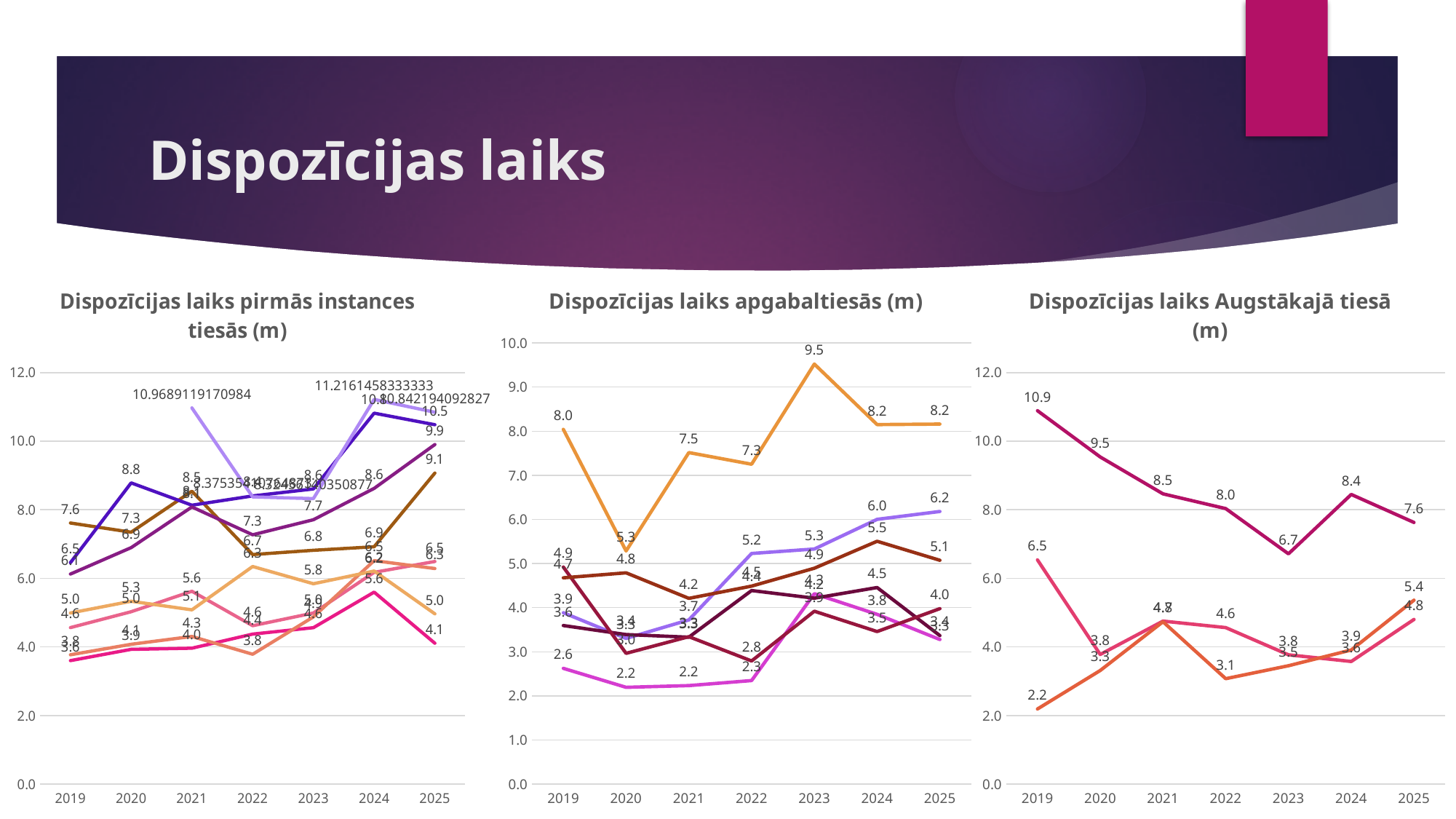
In the chart "Dispozīcijas laiks Augstākajā tiesā (m)", does the top line rise or fall from 2019 to 2023? fall What kind of chart is the chart titled "Dispozīcijas laiks Augstākajā tiesā (m)"? line chart In the chart "Dispozīcijas laiks apgabaltiesās (m)", which is larger for the top (orange) line: the 2019 value or the 2020 value? 2019 (8.0) In the chart "Dispozīcijas laiks apgabaltiesās (m)", is the 2023 value of the top (orange) line greater or less than 9.0? greater In the chart "Dispozīcijas laiks apgabaltiesās (m)", what is the highest value labeled on the chart? 9.5 How many charts are shown on the slide? 3 In the chart "Dispozīcijas laiks Augstākajā tiesā (m)", what is the 2025 value of the line that starts at 10.9 in 2019? 7.6 In the chart "Dispozīcijas laiks Augstākajā tiesā (m)", what is the lowest value labeled on the chart? 2.2 In the chart "Dispozīcijas laiks Augstākajā tiesā (m)", what is the difference between the 2019 value (10.9) and the 2025 value (7.6) of the top line? 3.3 In the chart "Dispozīcijas laiks apgabaltiesās (m)", how many years are shown on the x axis? 7 In the chart "Dispozīcijas laiks apgabaltiesās (m)", in which year does the highest labeled value (9.5) occur? 2023 In the chart "Dispozīcijas laiks Augstākajā tiesā (m)", what is the highest value labeled on the chart? 10.9